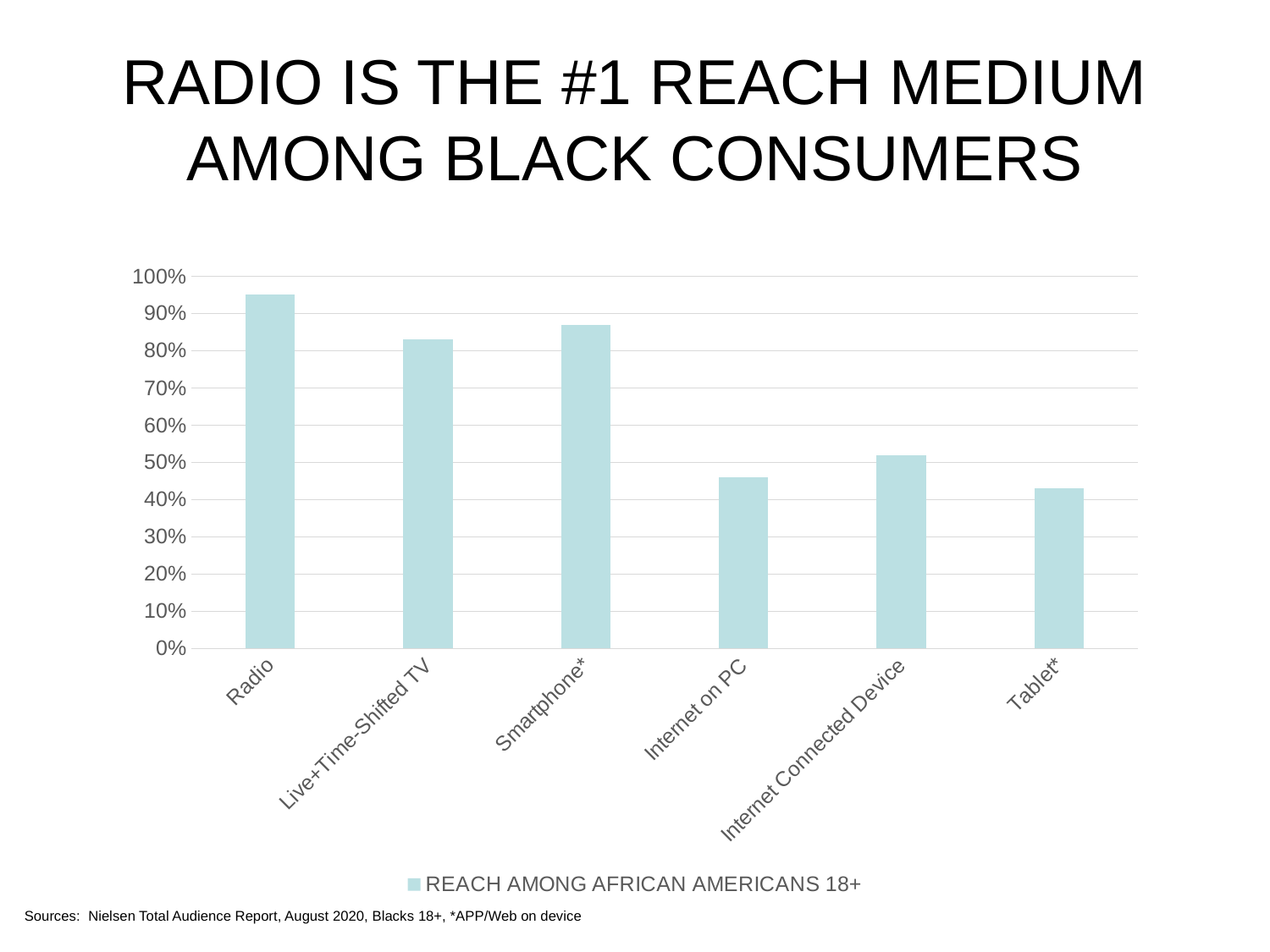
How many series does the legend list? 1 Which is larger, the value for Internet Connected Device or the value for Internet on PC? Internet Connected Device Which category has the highest reach on the chart? Radio Is the value for Internet Connected Device greater or less than 50%? greater Is the value for Internet on PC greater or less than 50%? less Is the value for Live+Time-Shifted TV greater or less than 80%? greater How many categories are plotted on the chart? 6 Which is larger, the value for Radio or the value for Smartphone*? Radio What is the legend entry shown below the chart? REACH AMONG AFRICAN AMERICANS 18+ What kind of chart is shown on the slide? bar chart